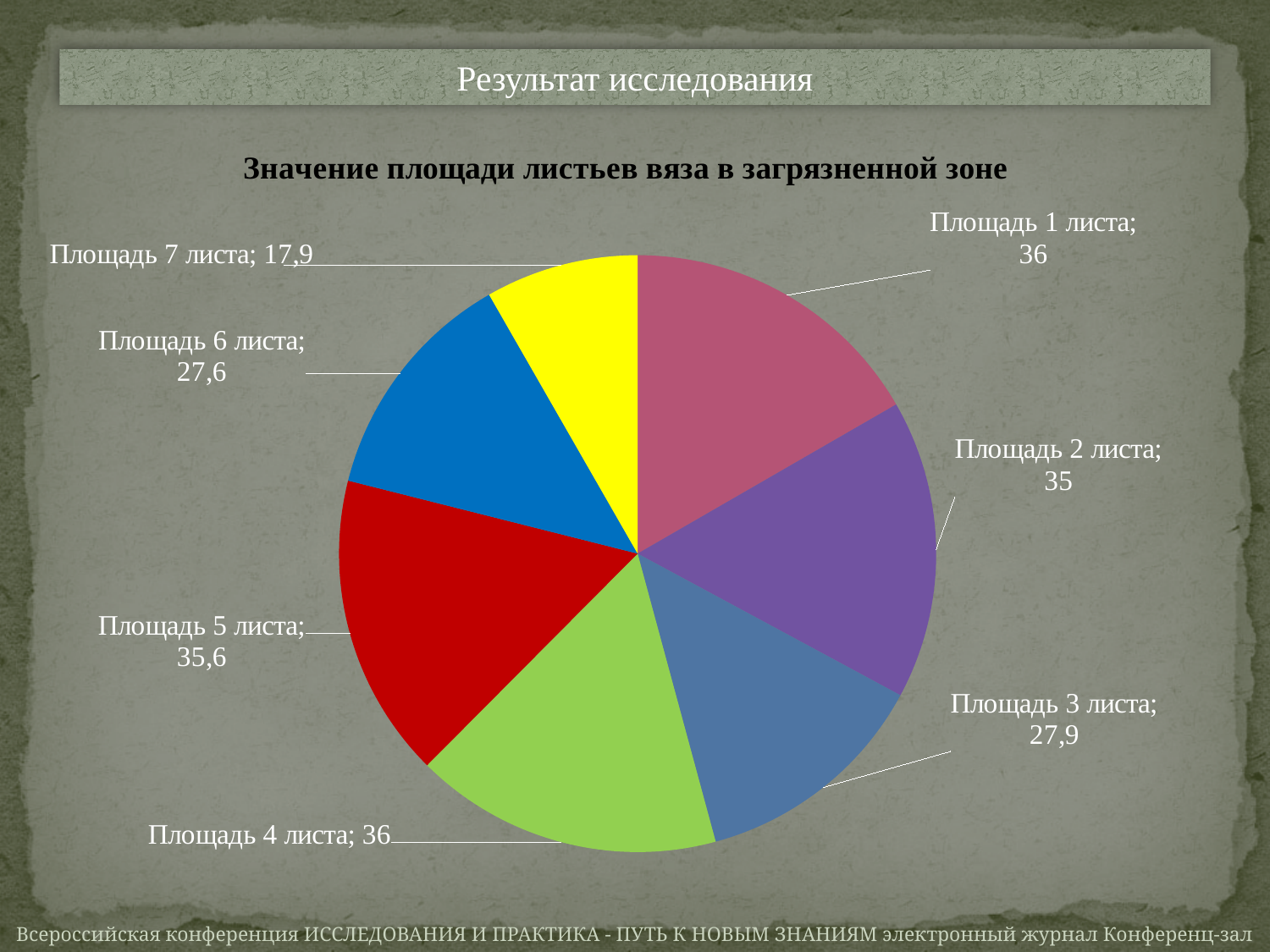
Which is larger, the value for Площадь 2 листа or Площадь 6 листа? Площадь 2 листа What kind of chart is shown on the slide? pie chart What is the value for Площадь 1 листа? 36 What is the value for Площадь 5 листа? 35,6 What colour is the slice for Площадь 7 листа? yellow What is the value for Площадь 7 листа? 17,9 Which slice has the smallest value? Площадь 7 листа What is the title of the chart? Значение площади листьев вяза в загрязненной зоне What is the difference between the values for Площадь 4 листа and Площадь 7 листа? 18,1 What is the value for Площадь 3 листа? 27,9 How many slices does the pie chart have? 7 What is the difference between the values for Площадь 1 листа and Площадь 3 листа? 8,1